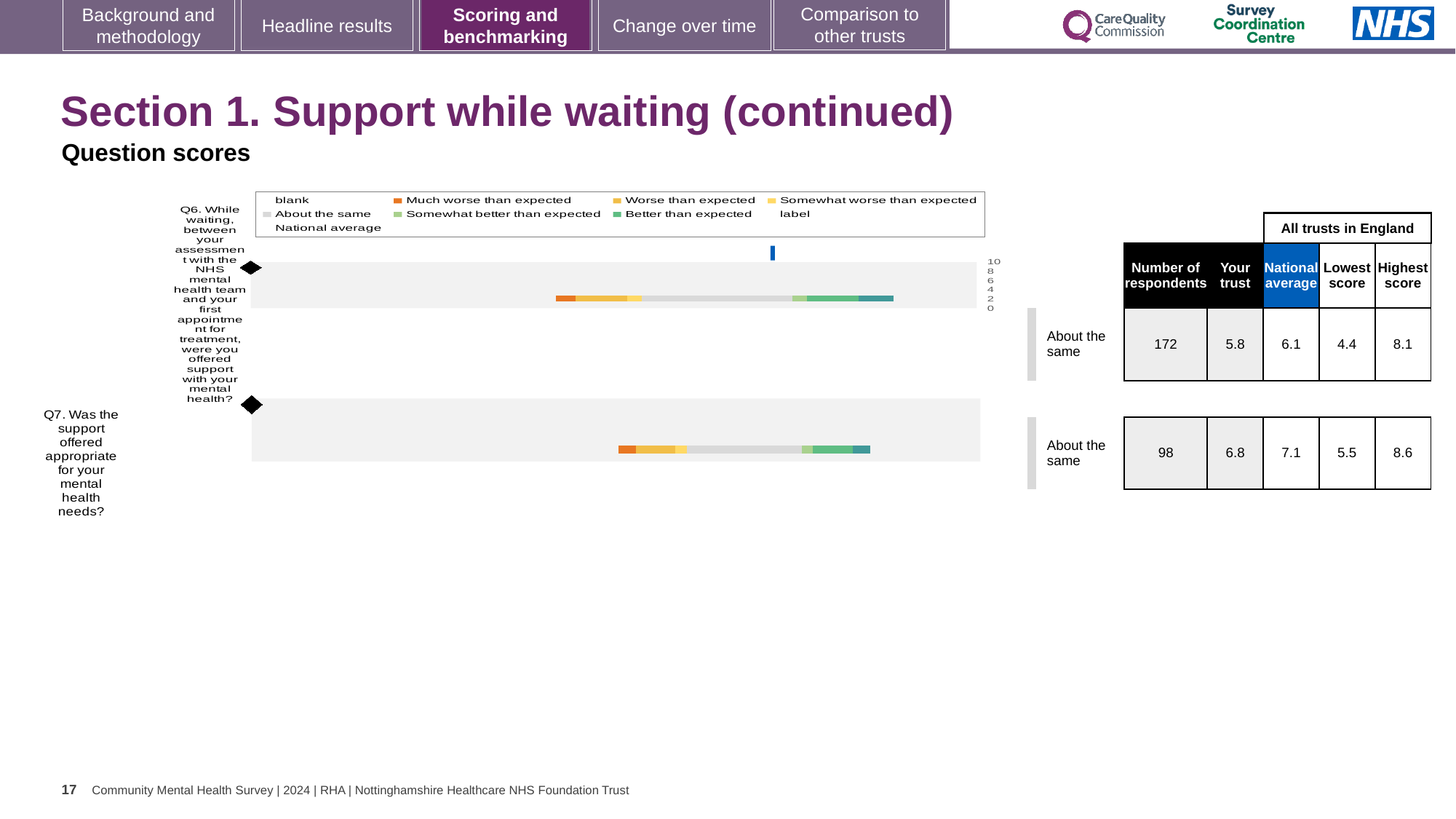
What is the lowest score across all trusts in England for Q7? 5.5 Which question had more respondents, Q6 or Q7? Q6 How many survey questions are plotted as bars in the chart? 2 In the chart legend, what colour represents 'Much worse than expected'? orange What is the difference between the highest score and the lowest score for Q7 in the table? 3.1 What kind of chart is shown on the slide? bar chart What benchmark category label is shown next to both Q6 and Q7 bars? About the same What is the national average score for Q7 in the table beside the chart? 7.1 For Q6, which is larger: the 'Your trust' score or the national average? National average What is the 'Your trust' score for Q6 in the table beside the chart? 5.8 How many respondents answered Q6 according to the table beside the chart? 172 What is the difference between the national average and the 'Your trust' score for Q6? 0.3